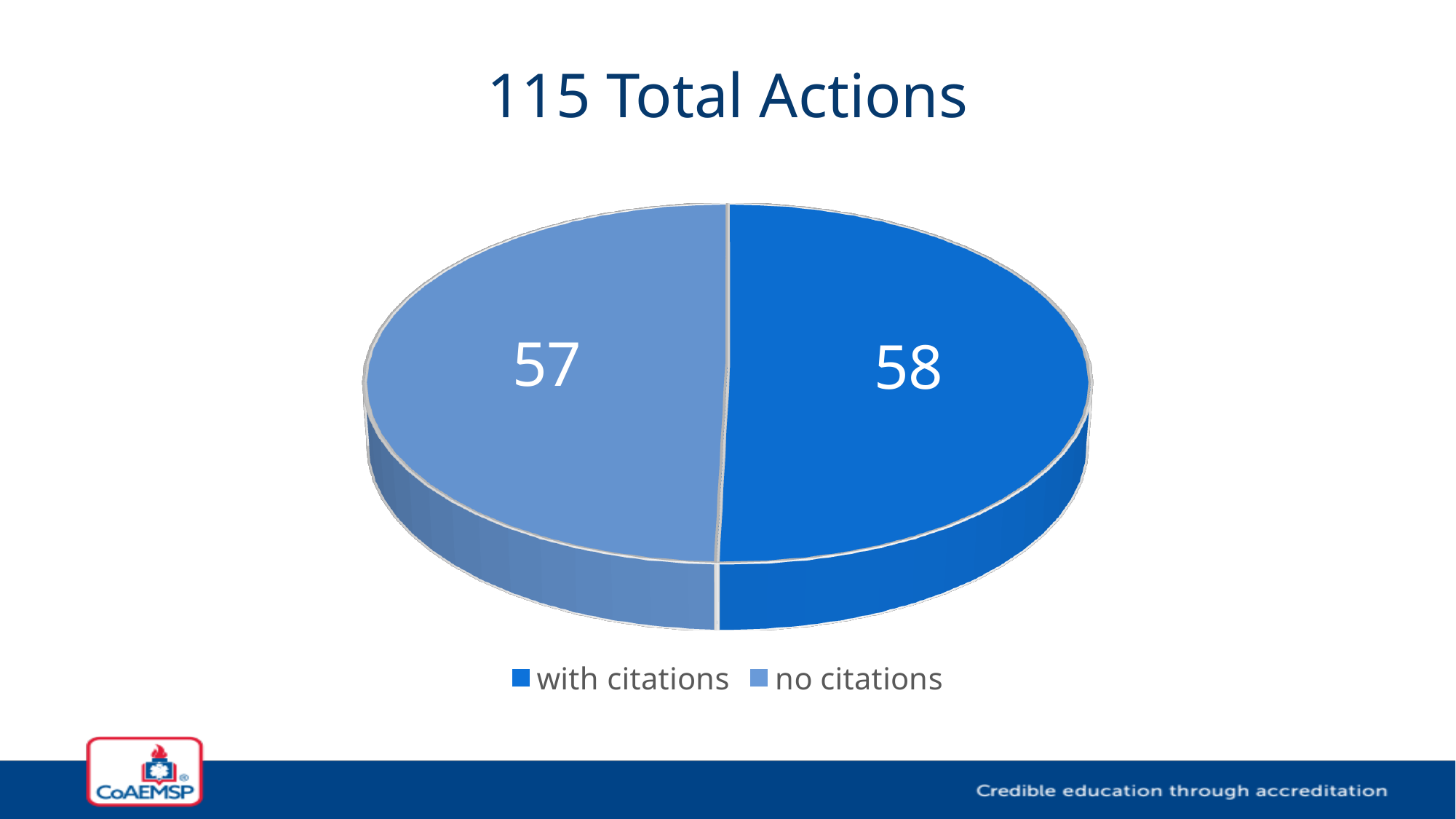
What is the total of the two slices in the pie chart? 115 What is the difference between the 'with citations' and 'no citations' values? 1 How many entries does the legend list? 2 How many slices does the pie chart have? 2 What kind of chart is shown on the slide? pie chart Which legend entry is shown in the darker blue colour? with citations Which category has the highest value in the pie chart? with citations What is the value of the 'with citations' slice? 58 Which slice has the larger value, 'with citations' or 'no citations'? with citations What is the value of the 'no citations' slice? 57 Which category has the lowest value in the pie chart? no citations What is the title of the chart? 115 Total Actions